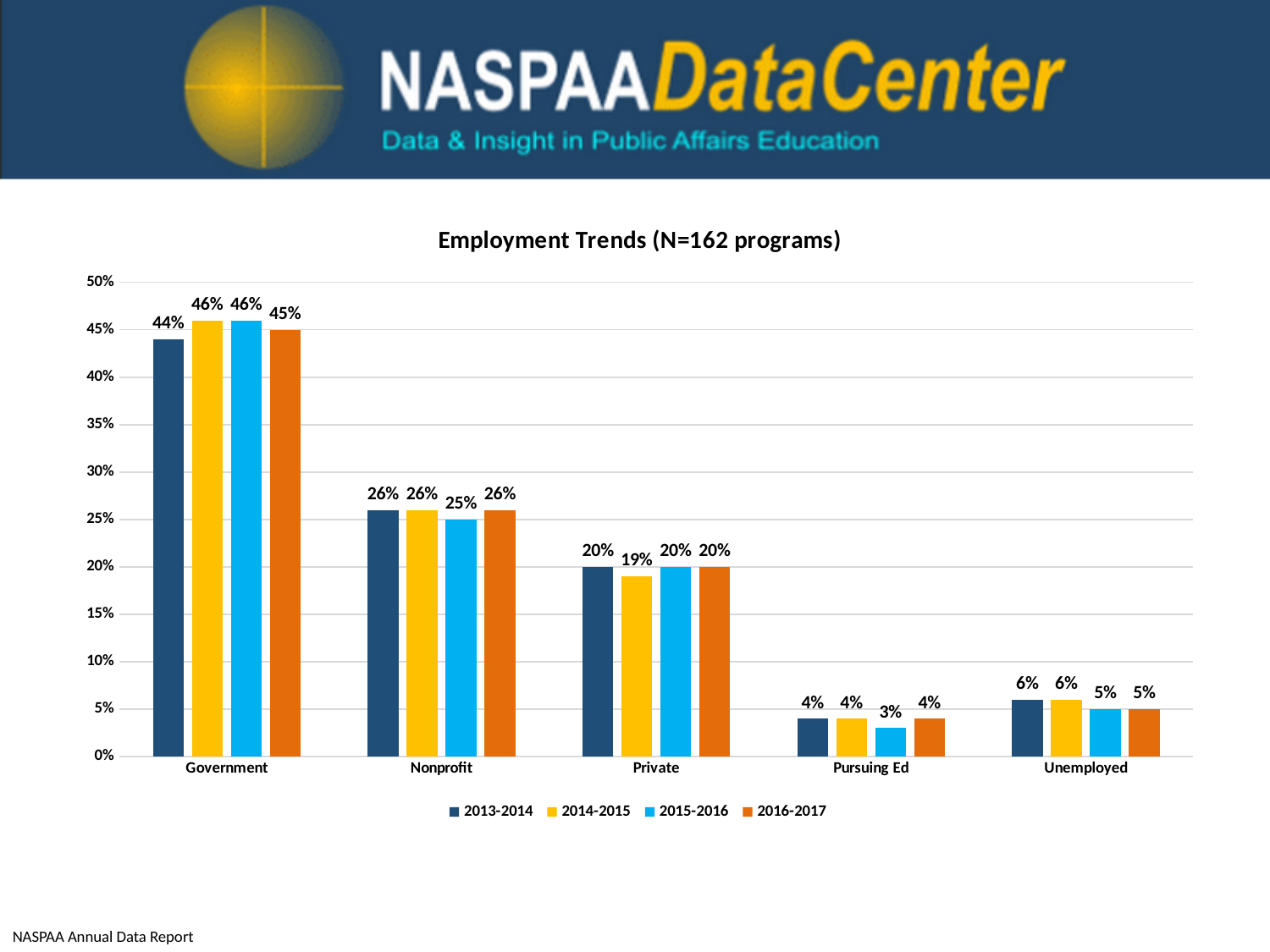
What is the value for Pursuing Ed in 2015-2016? 3% What is the value for Private in 2014-2015? 19% What is the title of the chart? Employment Trends (N=162 programs) Which series is shown in orange in the legend? 2016-2017 What kind of chart is shown on the slide? Bar chart How many categories are shown on the x axis? 5 How many series does the legend list? 4 Which category has the lowest value in 2015-2016? Pursuing Ed What is the difference between the Government value in 2014-2015 and the Government value in 2013-2014? 2% Which category has the highest value in 2016-2017? Government What is the value for Government in 2013-2014? 44% Which is larger: the Nonprofit value in 2013-2014 or the Nonprofit value in 2015-2016? Nonprofit in 2013-2014